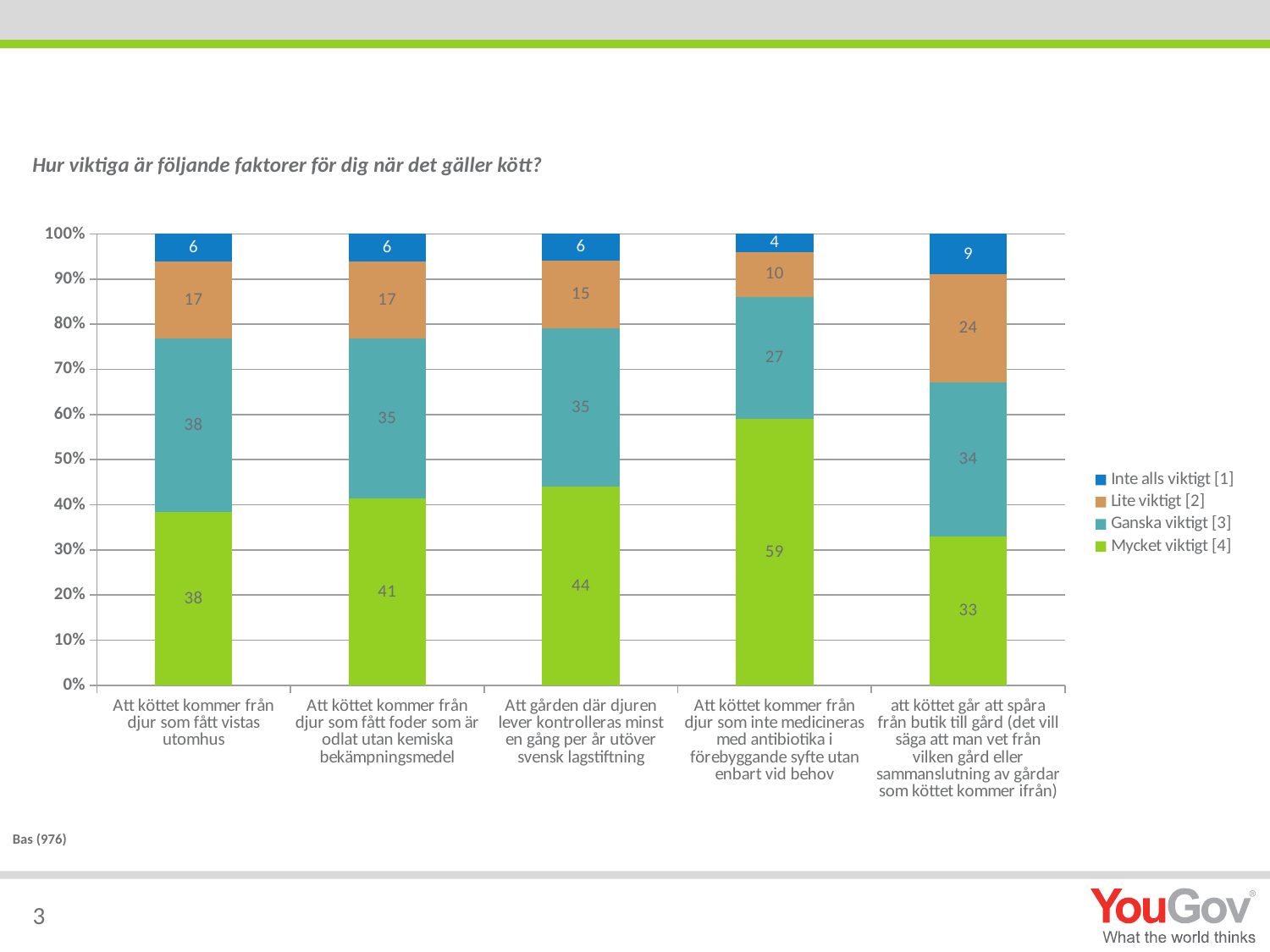
What is the difference between the "Mycket viktigt [4]" values for "Att gården där djuren lever kontrolleras minst en gång per år utöver svensk lagstiftning" and "Att köttet kommer från djur som fått vistas utomhus"? 6 What is the value of "Ganska viktigt [3]" for "Att gården där djuren lever kontrolleras minst en gång per år utöver svensk lagstiftning"? 35 Which category has the lowest value for "Mycket viktigt [4]"? att köttet går att spåra från butik till gård What is the value of "Inte alls viktigt [1]" for "Att köttet kommer från djur som fått vistas utomhus"? 6 Which is larger: the "Lite viktigt [2]" value for "att köttet går att spåra från butik till gård" or for "Att köttet kommer från djur som inte medicineras med antibiotika"? att köttet går att spåra från butik till gård How many categories are shown on the x axis? 5 What kind of chart is shown on the slide? Stacked bar chart How many series does the legend list? 4 Which legend entry is shown in green? Mycket viktigt [4] What is the value of "Lite viktigt [2]" for "att köttet går att spåra från butik till gård"? 24 What is the value of "Mycket viktigt [4]" for "Att köttet kommer från djur som inte medicineras med antibiotika i förebyggande syfte utan enbart vid behov"? 59 Which category has the highest value for "Mycket viktigt [4]"? Att köttet kommer från djur som inte medicineras med antibiotika i förebyggande syfte utan enbart vid behov